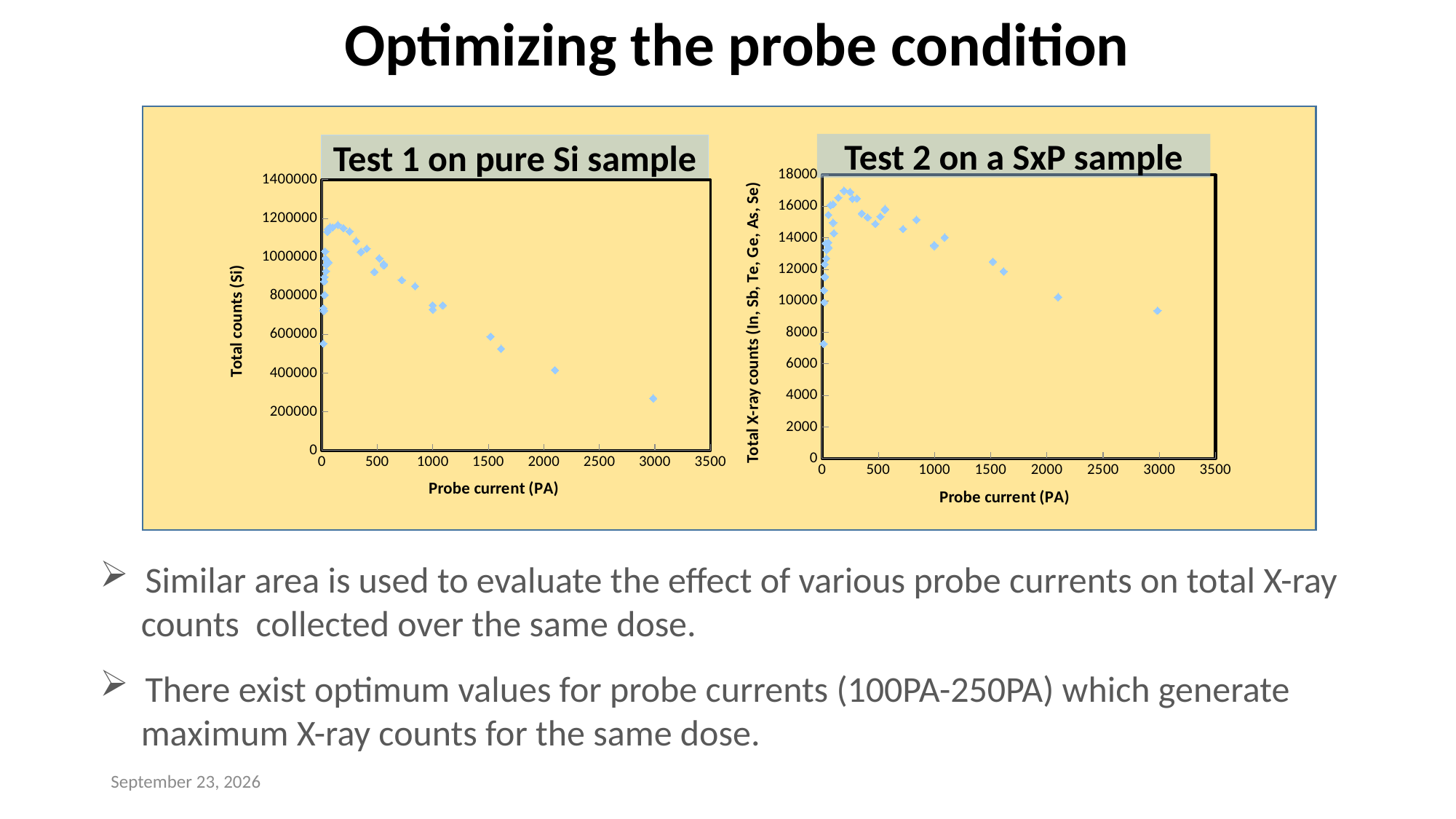
In the 'Test 2 on a SxP sample' chart, do the total X-ray counts rise or fall as probe current increases from 1000 PA to 3000 PA? fall In the 'Test 2 on a SxP sample' chart, is the total X-ray counts value at a probe current of about 3000 PA greater or less than 10000? less What kind of chart is the 'Test 1 on pure Si sample' chart? scatter chart In the 'Test 2 on a SxP sample' chart, is the highest total X-ray counts value greater or less than 16000? greater In the 'Test 1 on pure Si sample' chart, is the highest total counts value greater or less than 1000000? greater In the 'Test 1 on pure Si sample' chart, do the total counts rise or fall as probe current increases from 1000 PA to 3000 PA? fall In the 'Test 2 on a SxP sample' chart, what is the highest value shown on the y axis? 18000 In the 'Test 1 on pure Si sample' chart, which is larger: the total counts at about 1500 PA or at about 3000 PA? about 1500 PA In the 'Test 2 on a SxP sample' chart, what is the label of the y axis? Total X-ray counts (In, Sb, Te, Ge, As, Se) What kind of chart is the 'Test 2 on a SxP sample' chart? scatter chart In the 'Test 1 on pure Si sample' chart, what is the label of the x axis? Probe current (PA)